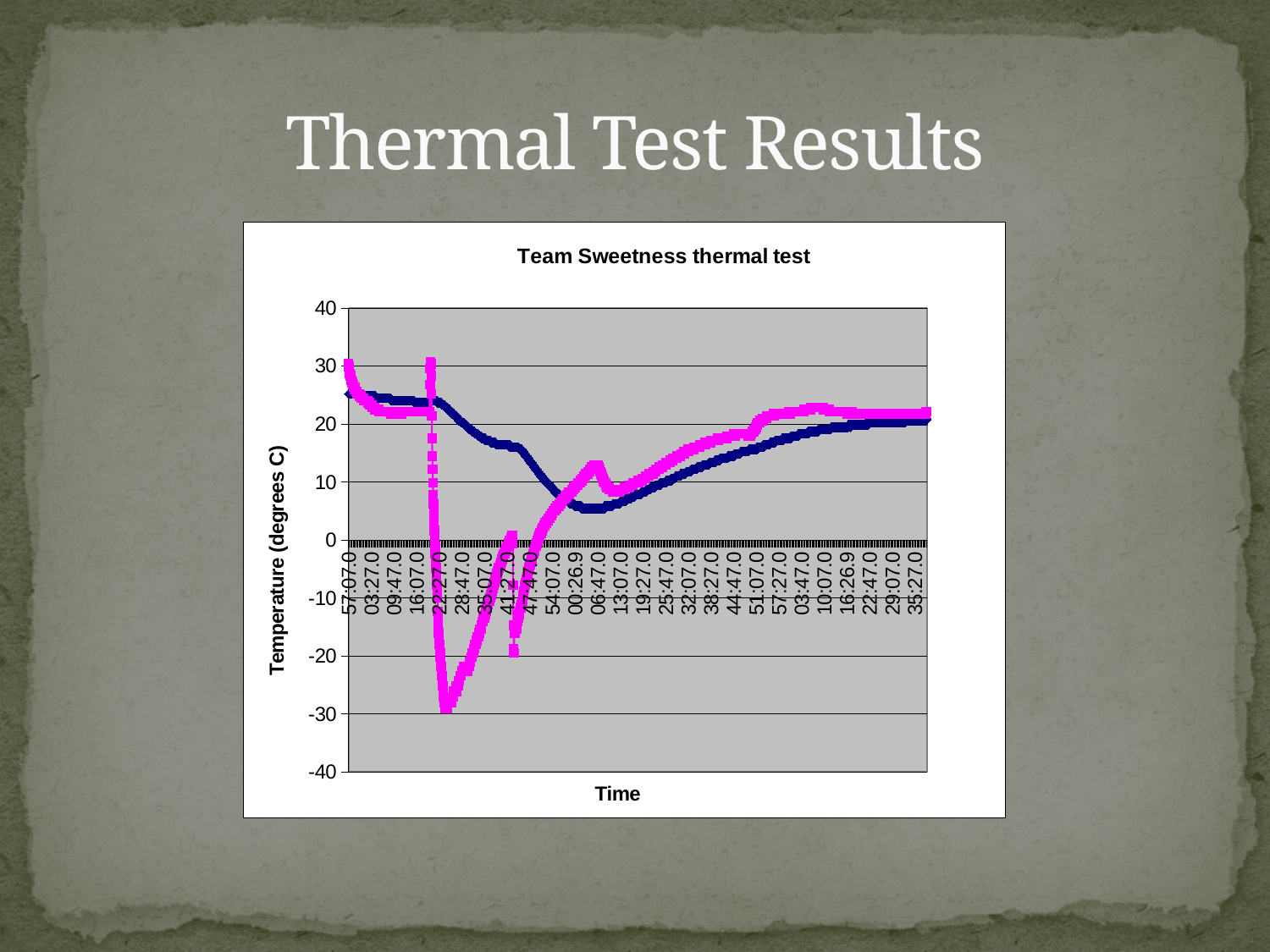
What is the label on the vertical axis of the chart? Temperature (degrees C) Is the lowest value reached by the dark blue series greater or less than 10? less What is the title of the chart? Team Sweetness thermal test Is the first value of the dark blue series greater or less than 20? greater Is the highest value reached by the magenta series greater or less than 20? greater How many data series are plotted on the chart? 2 Which series reaches the lower minimum temperature, the dark blue series or the magenta series? magenta series What kind of chart is shown on the slide? line chart Does the dark blue series rise or fall between the start of the test and about 06:47.0? fall Does the dark blue series rise or fall between about 06:47.0 and the end of the test? rise